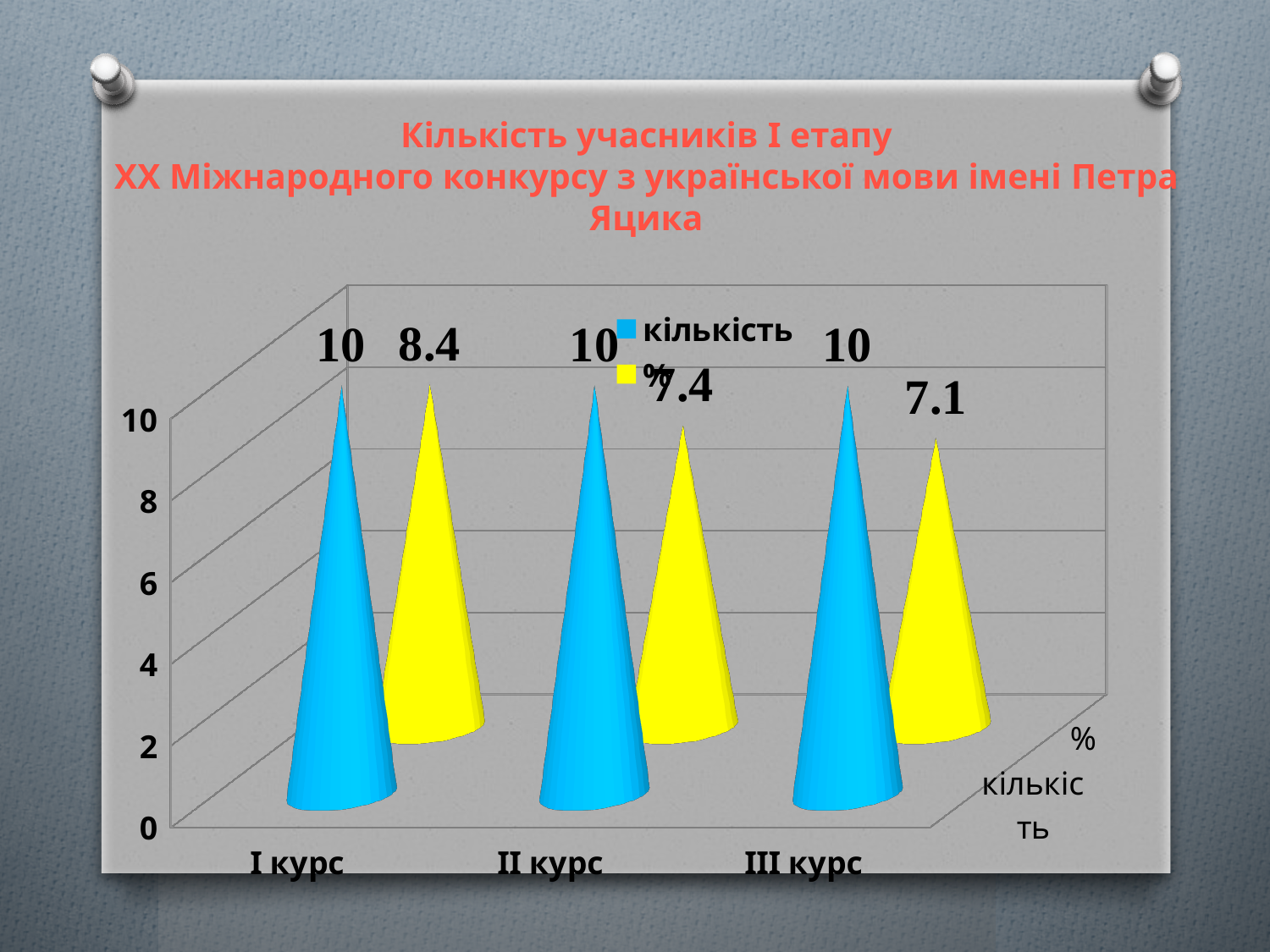
What is the value of the "%" series for I курс? 8.4 What is the value of the "%" series for III курс? 7.1 Which category has the lowest value in the "%" series? III курс What is the value of the "%" series for II курс? 7.4 How many series does the legend list? 2 Do the values of the "%" series rise or fall from I курс to III курс? fall What is the value of the "кількість" series for II курс? 10 What colour represents the "кількість" series? blue Which category has the highest value in the "%" series? I курс Which is larger: the "%" value for II курс or for III курс? II курс How many categories are shown on the x axis? 3 What is the difference between the "%" values for I курс and III курс? 1.3